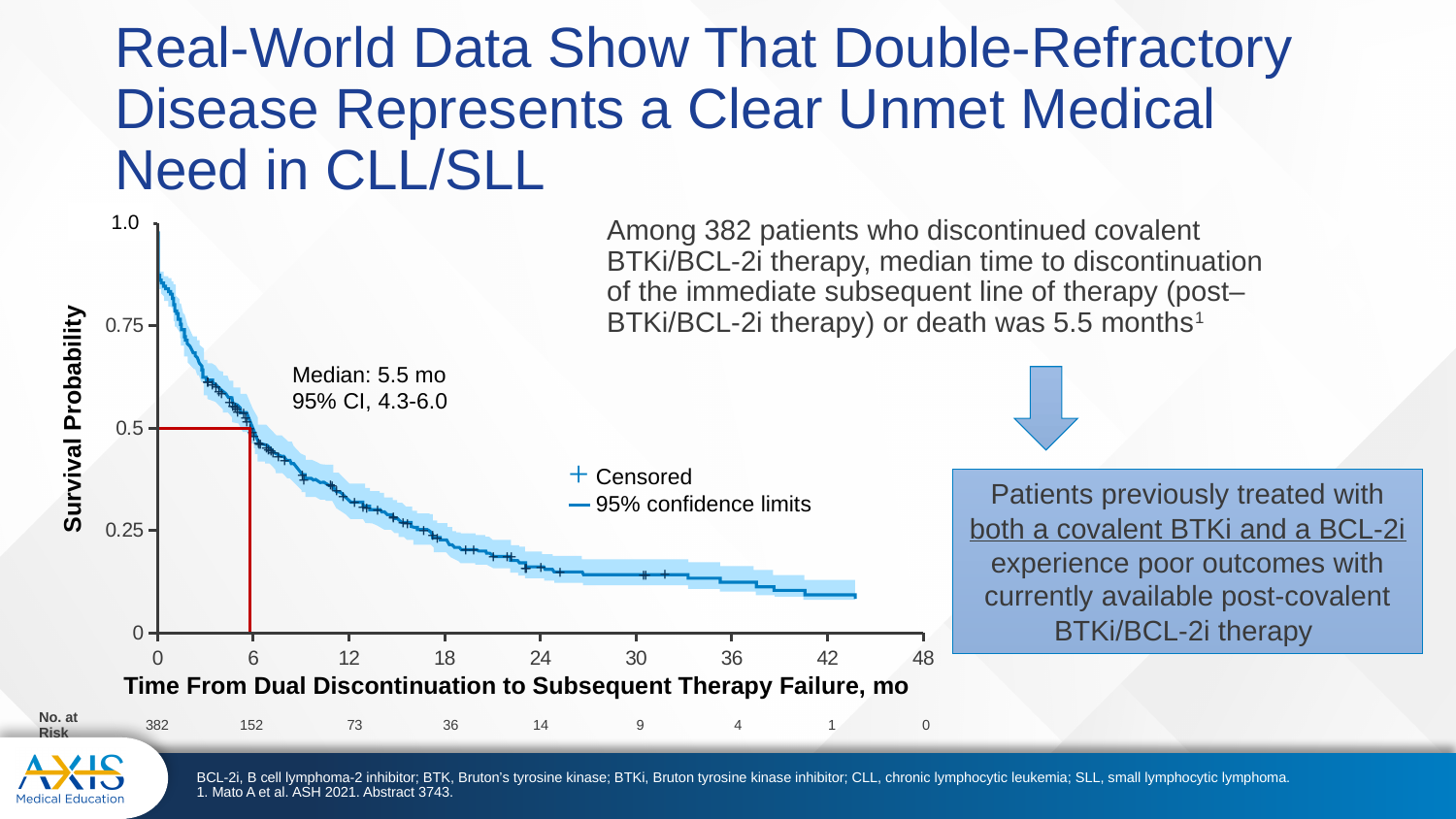
What is the label of the x axis? Time From Dual Discontinuation to Subsequent Therapy Failure, mo How many time points are listed in the number-at-risk row below the chart? 9 What is the difference between the number at risk at 0 months and at 6 months? 230 Is the survival probability at 12 months greater or less than 0.5? less What is the 95% confidence interval for the median shown on the chart? 4.3-6.0 How many patients are at risk at 0 months? 382 Which has more patients at risk, 18 months or 30 months? 18 months What kind of chart is shown on the slide? line chart What is the median time from dual discontinuation to subsequent therapy failure shown on the chart? 5.5 mo How many patients are at risk at 24 months? 14 Does the survival probability rise or fall as time increases along the x axis? fall How many patients are at risk at 6 months? 152